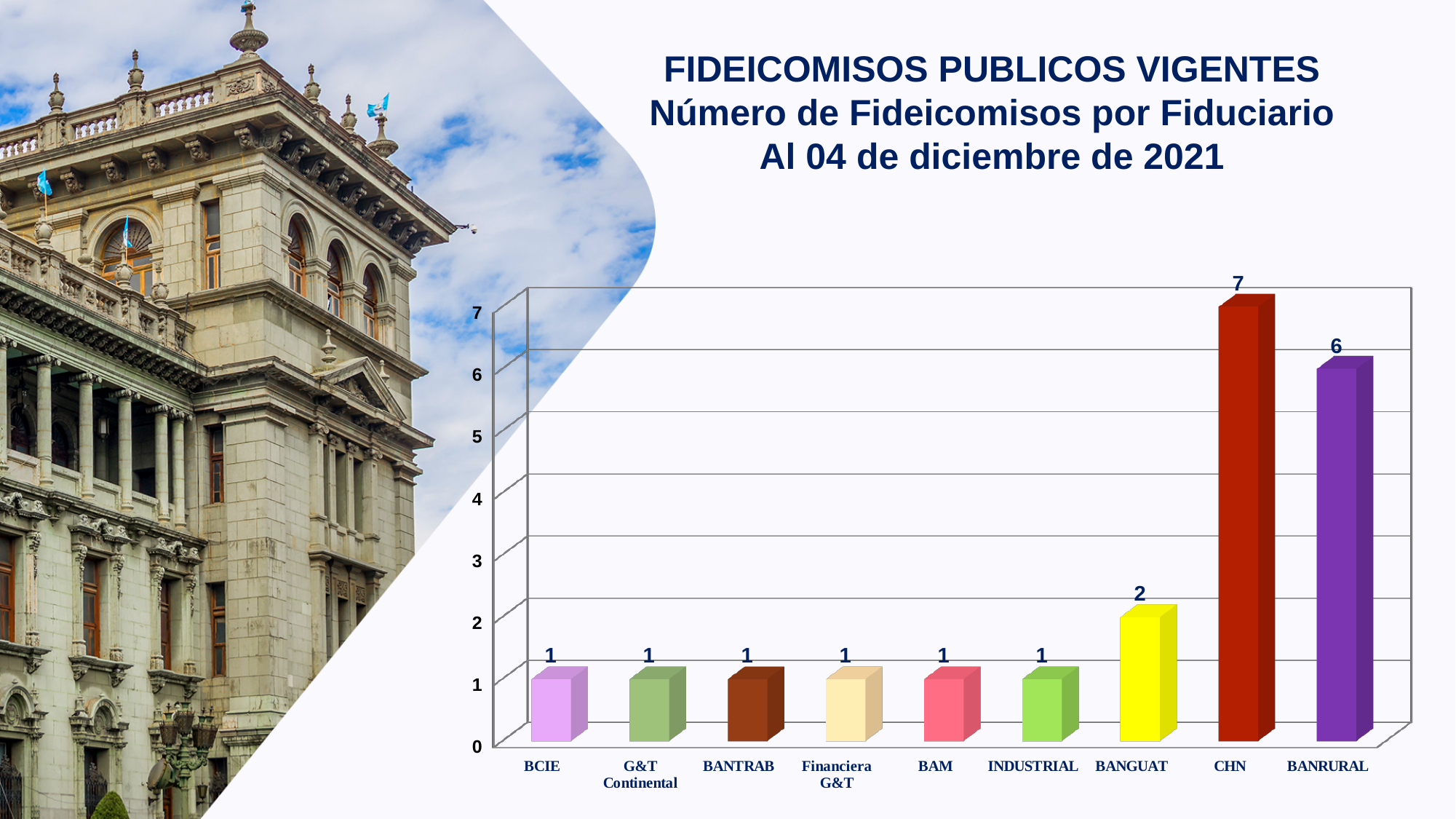
What is the difference between the values for CHN and BANRURAL? 1 How many fiduciarios have a value of 1? 6 What is the value shown for BANGUAT? 2 What is the difference between the values for BANRURAL and BANGUAT? 4 What is the value shown for BANRURAL? 6 Which is larger, the value for BANGUAT or the value for INDUSTRIAL? BANGUAT How many fideicomisos does CHN have? 7 Which fiduciario has the highest number of fideicomisos? CHN What kind of chart is shown on the slide? Bar chart How many fiduciarios are shown on the x axis? 9 What is the value shown for BCIE? 1 What date does the chart title say the data is as of? 04 de diciembre de 2021